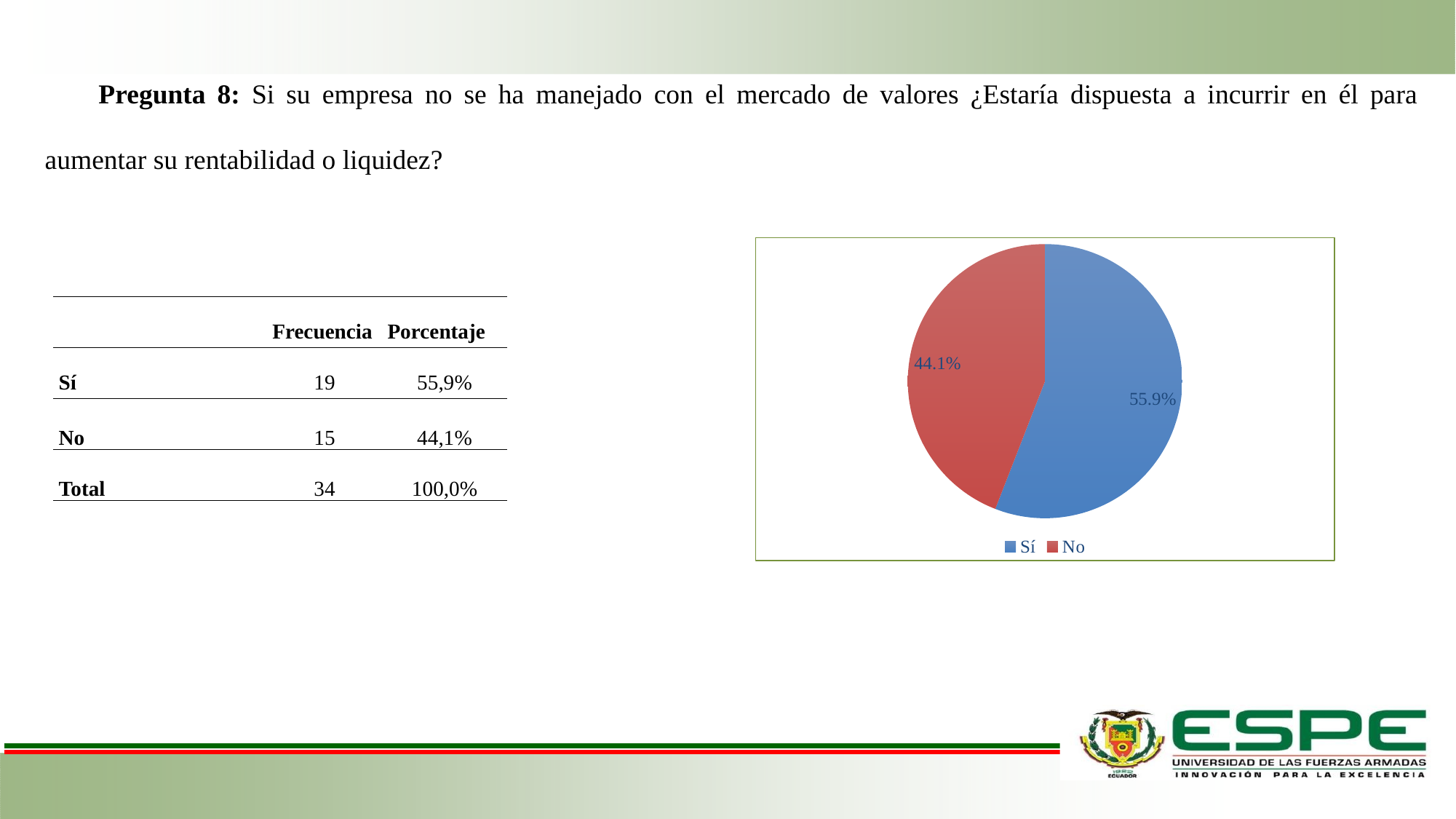
Which slice of the pie chart is the smallest? No Which is larger in the pie chart, Sí or No? Sí What colour is the Sí slice in the pie chart? blue What is the difference in percentage points between the Sí and No slices? 11.8 How many slices does the pie chart have? 2 What colour is the No slice in the pie chart? red What share of the pie does the No slice represent? 44.1% How many entries does the legend of the pie chart list? 2 What share of the pie does the Sí slice represent? 55.9% Which slice of the pie chart is the largest? Sí What kind of chart is shown on the slide? pie chart